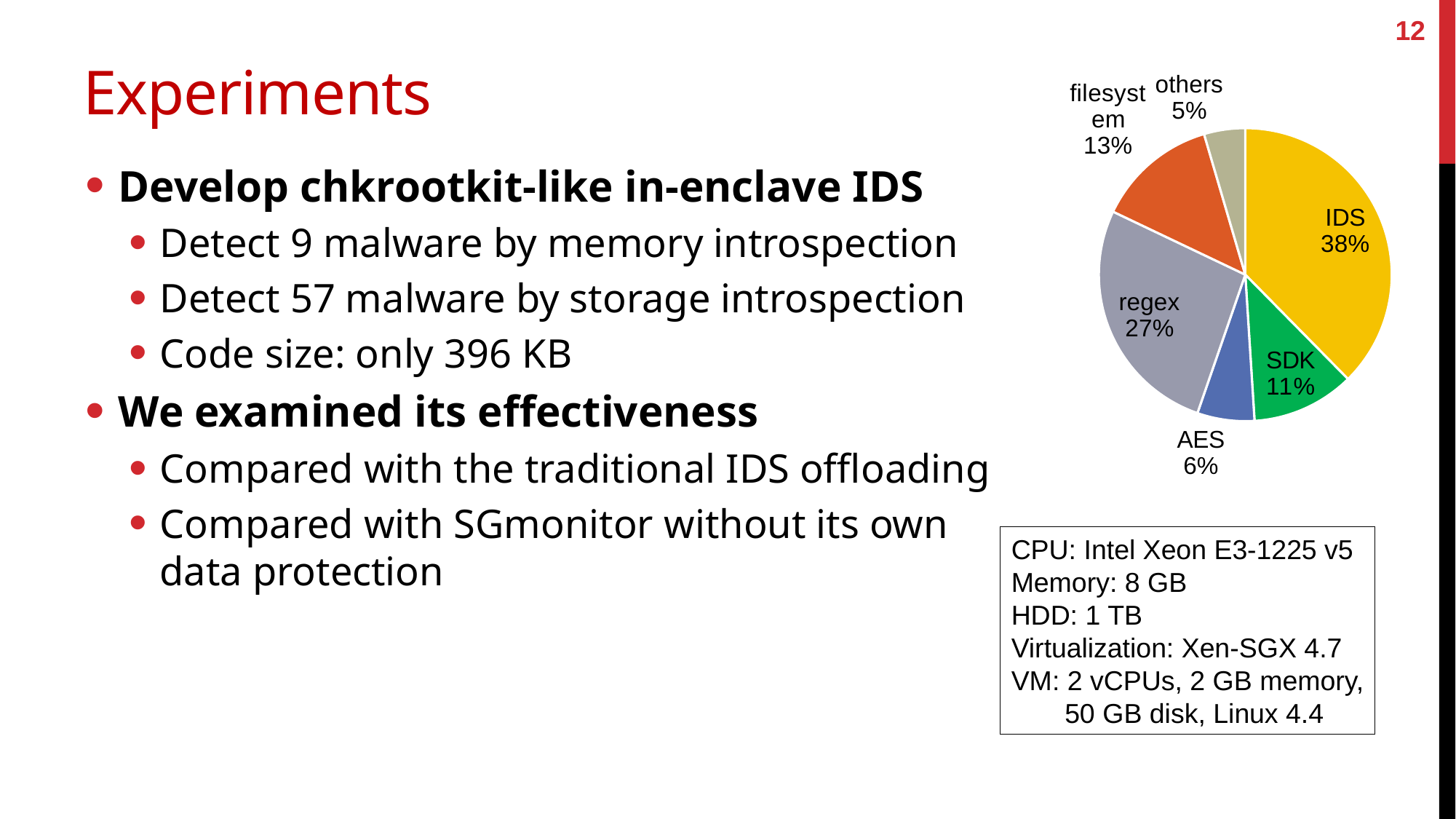
What is the difference in percentage points between IDS and regex? 11 Which slice of the pie is the largest? IDS What colour is the IDS slice of the pie? yellow What share of the pie does IDS account for? 38% Which is larger, the share for SDK or the share for AES? SDK What kind of chart is shown on the slide? pie chart What is the value shown for SDK? 11% What is the value shown for regex? 27% Which slice of the pie is the smallest? others What is the value shown for filesystem? 13% What is the combined share of AES and others? 11% How many slices does the pie chart have? 6